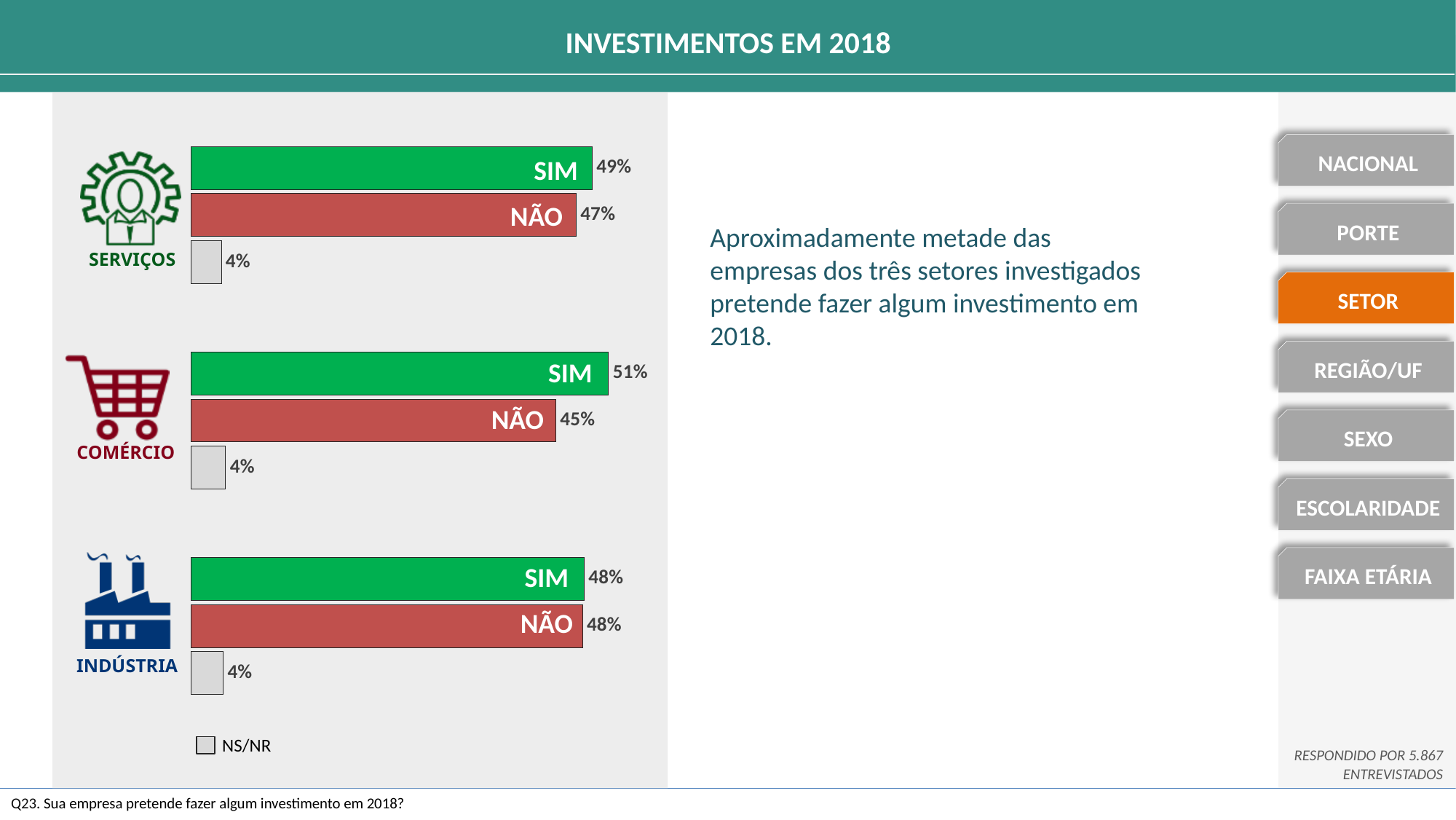
What is the difference between SIM and NÃO for Serviços? 2% What is the NS/NR value for Indústria? 4% Which sector has the lowest NÃO percentage? Comércio What percentage of Serviços companies answered SIM? 49% Which sector has the highest SIM percentage? Comércio For Serviços, which is larger, SIM or NÃO? SIM What is the NÃO value for Comércio? 45% What kind of chart is used to show the investment intentions by sector? Bar chart What is the NÃO value for Indústria? 48% How many sectors are shown in the chart? 3 What does the grey bar represent according to the legend? NS/NR What is the difference between SIM and NÃO for Comércio? 6%